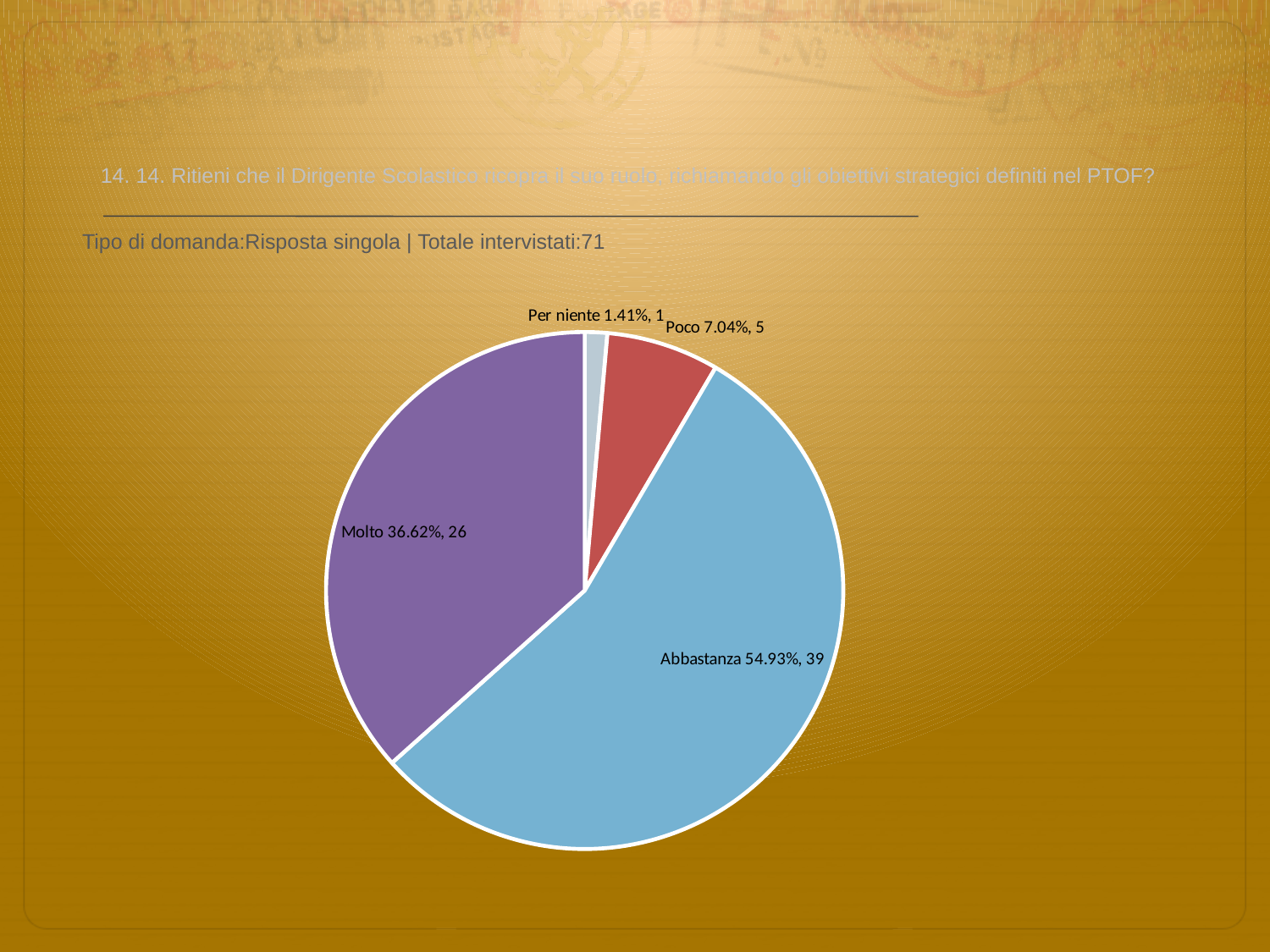
What percentage share does the Per niente slice have? 1.41% What is the difference in respondent count between Abbastanza and Molto? 13 Which has more respondents, Poco or Per niente? Poco How many respondents answered Poco? 5 How many respondents answered Molto? 26 What percentage share does the Abbastanza slice have? 54.93% What colour is the Molto slice? purple How many slices does the pie chart have? 4 Which category has the largest slice? Abbastanza What is the total number of respondents across all slices? 71 What kind of chart is shown on the slide? pie chart Which category has the smallest slice? Per niente